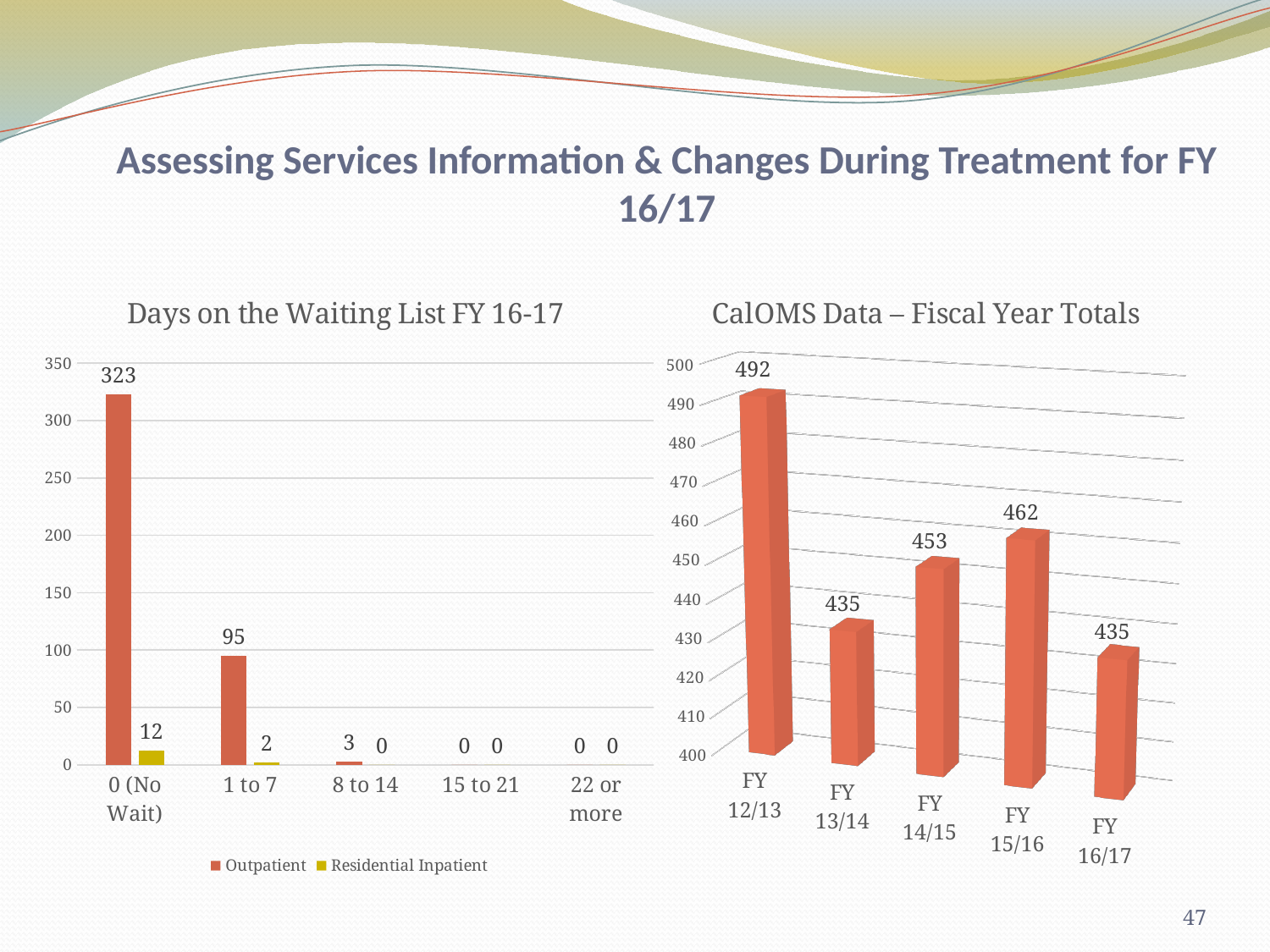
What kind of chart is 'CalOMS Data – Fiscal Year Totals'? Bar chart In the 'CalOMS Data – Fiscal Year Totals' chart, what is the difference between FY 12/13 and FY 16/17? 57 In the 'Days on the Waiting List FY 16-17' chart, how many categories are shown on the x axis? 5 In the 'Days on the Waiting List FY 16-17' chart, which category has the highest Outpatient value? 0 (No Wait) In the 'CalOMS Data – Fiscal Year Totals' chart, what is the value for FY 14/15? 453 In the 'CalOMS Data – Fiscal Year Totals' chart, which fiscal year has the highest total? FY 12/13 In the 'Days on the Waiting List FY 16-17' chart, what colour are the Residential Inpatient bars? Yellow In the 'Days on the Waiting List FY 16-17' chart, what is the Residential Inpatient value for '1 to 7'? 2 In the 'Days on the Waiting List FY 16-17' chart, what is the Outpatient value for '0 (No Wait)'? 323 In the 'Days on the Waiting List FY 16-17' chart, what is the difference between the Outpatient values for '0 (No Wait)' and '1 to 7'? 228 In the 'CalOMS Data – Fiscal Year Totals' chart, which is larger, FY 15/16 or FY 14/15? FY 15/16 In the 'Days on the Waiting List FY 16-17' chart, how many series does the legend list? 2